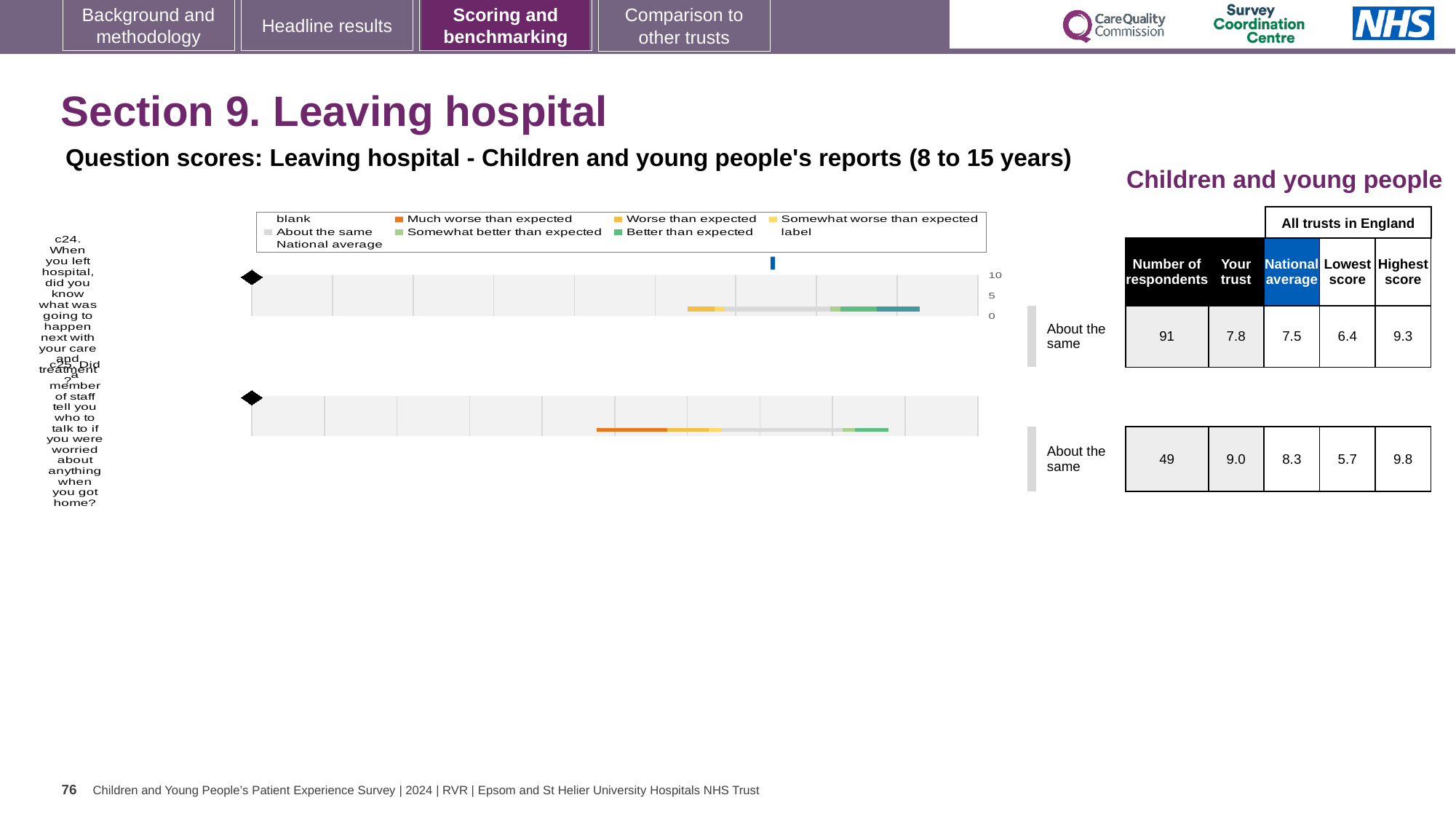
What is the difference between the highest score and the lowest score for question c24? 2.9 How many questions (bars) are plotted in the Leaving hospital chart? 2 Which question has the higher 'Your trust' score, c24 or c25? c25 What kind of chart is used to show the question scores for c24 and c25? bar chart What is the national average score for question c25 (Did a member of staff tell you who to talk to if you were worried about anything when you got home?)? 8.3 How many respondents answered question c24? 91 Which question has the higher 'Highest score' across all trusts in England, c24 or c25? c25 What colour represents 'Much worse than expected' in the chart legend? orange What benchmark category is shown for question c24? About the same What is the difference between the 'Your trust' score and the national average for question c25? 0.7 Is the 'Your trust' score for question c24 greater or less than 5 on the chart axis? greater What is the 'Your trust' score for question c24 (When you left hospital, did you know what was going to happen next with your care and treatment?)? 7.8